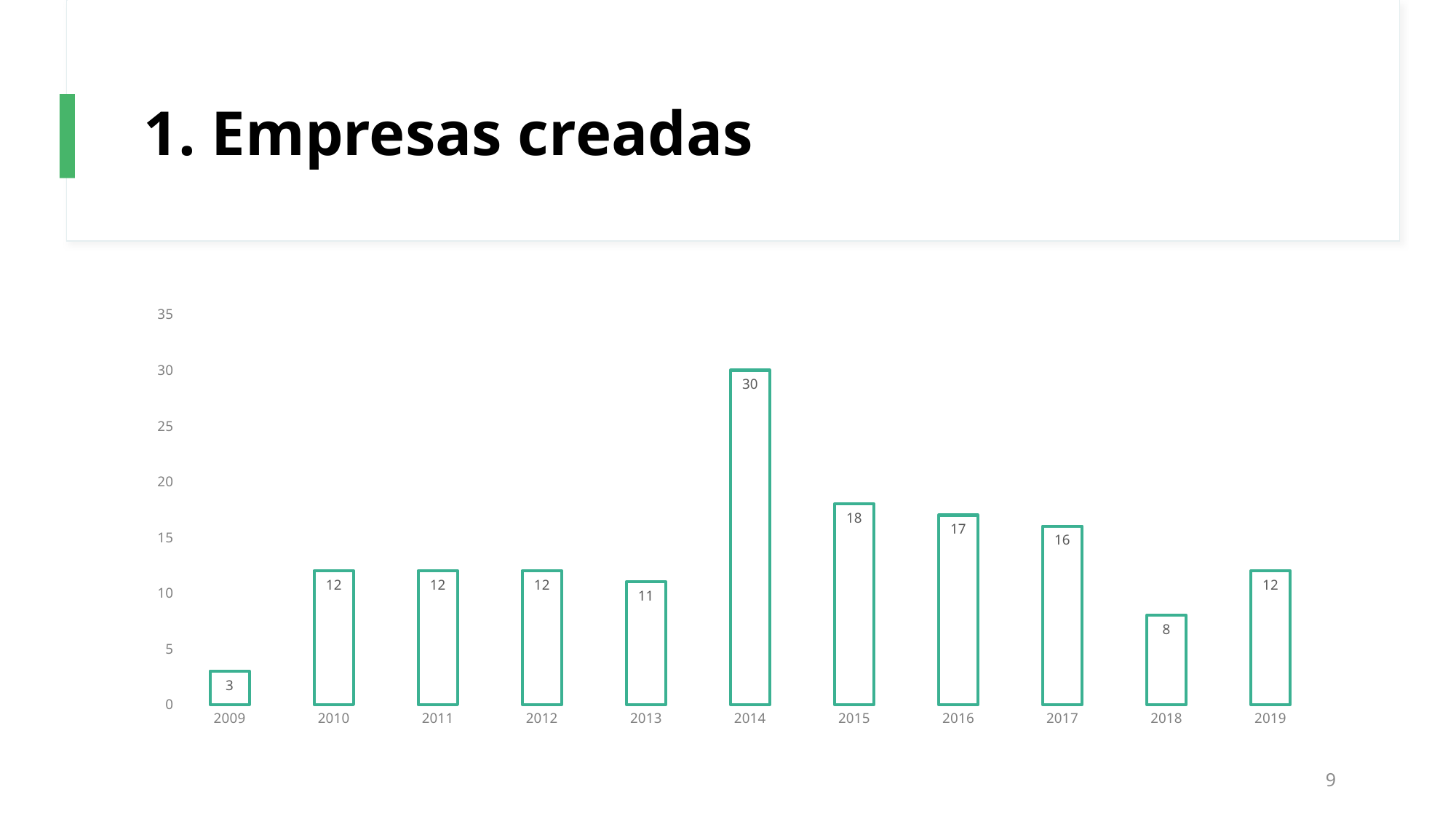
Which is larger, the value for 2016 or the value for 2017? 2016 Is the value for 2015 greater or less than 15? greater What is the value for 2018? 8 What is the difference between the values for 2019 and 2018? 4 What kind of chart is shown on the slide? bar chart What is the value for 2014? 30 What is the difference between the values for 2014 and 2015? 12 What is the value for 2009? 3 How many years are shown on the x axis? 11 Which year has the highest value? 2014 Do the values rise or fall from 2015 to 2018? fall Which year has the lowest value? 2009